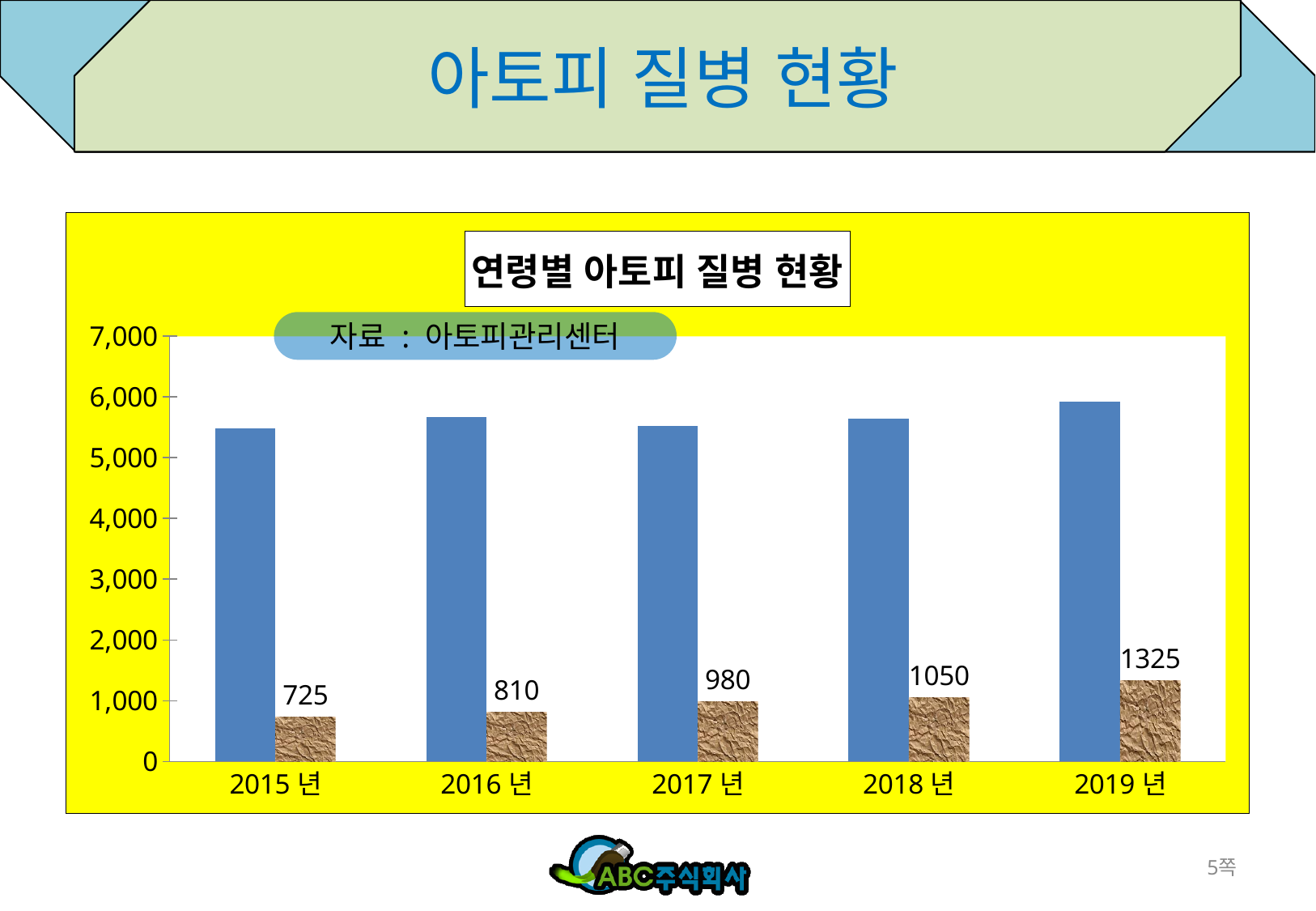
What is the value of the labelled brown bar for 2017 년? 980 What is the difference between the labelled brown bar values for 2018 년 and 2016 년? 240 Among the labelled brown bars, which year has the lowest value? 2015 년 Is the value of the blue bar for 2015 년 greater or less than 6,000? less What is the value of the labelled brown bar for 2015 년? 725 How many years are shown on the x axis of the chart? 5 Among the labelled brown bars, which year has the highest value? 2019 년 What is the difference between the labelled brown bar values for 2019 년 and 2015 년? 600 Which year has the taller blue bar, 2015 년 or 2019 년? 2019 년 Is the value of the blue bar for 2019 년 greater or less than 5,000? greater Do the labelled brown bar values rise or fall from 2015 년 to 2019 년? rise What is the value of the labelled brown bar for 2019 년? 1325